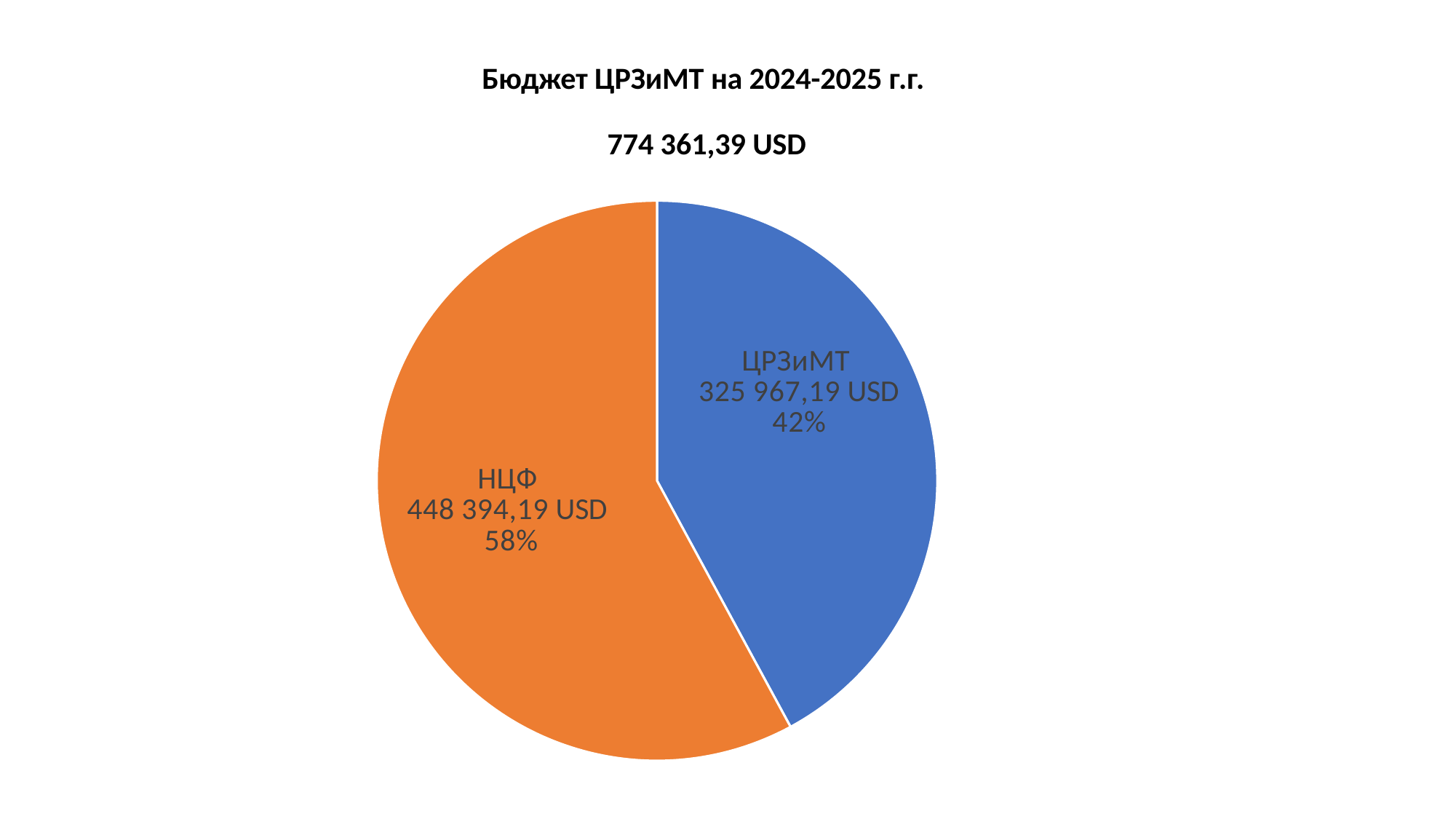
What is the value of the НЦФ slice? 448 394,19 USD Which slice is the smallest? ЦРЗиМТ What is the title of the chart? Бюджет ЦРЗиМТ на 2024-2025 г.г. What is the difference between the НЦФ value and the ЦРЗиМТ value? 122 427,00 USD What is the value of the ЦРЗиМТ slice? 325 967,19 USD What kind of chart is shown on the slide? pie chart Which is larger, the НЦФ slice or the ЦРЗиМТ slice? НЦФ What share of the pie does ЦРЗиМТ represent? 42% What share of the pie does НЦФ represent? 58% What total amount is printed under the chart title? 774 361,39 USD How many slices does the pie chart have? 2 Which slice is the largest? НЦФ